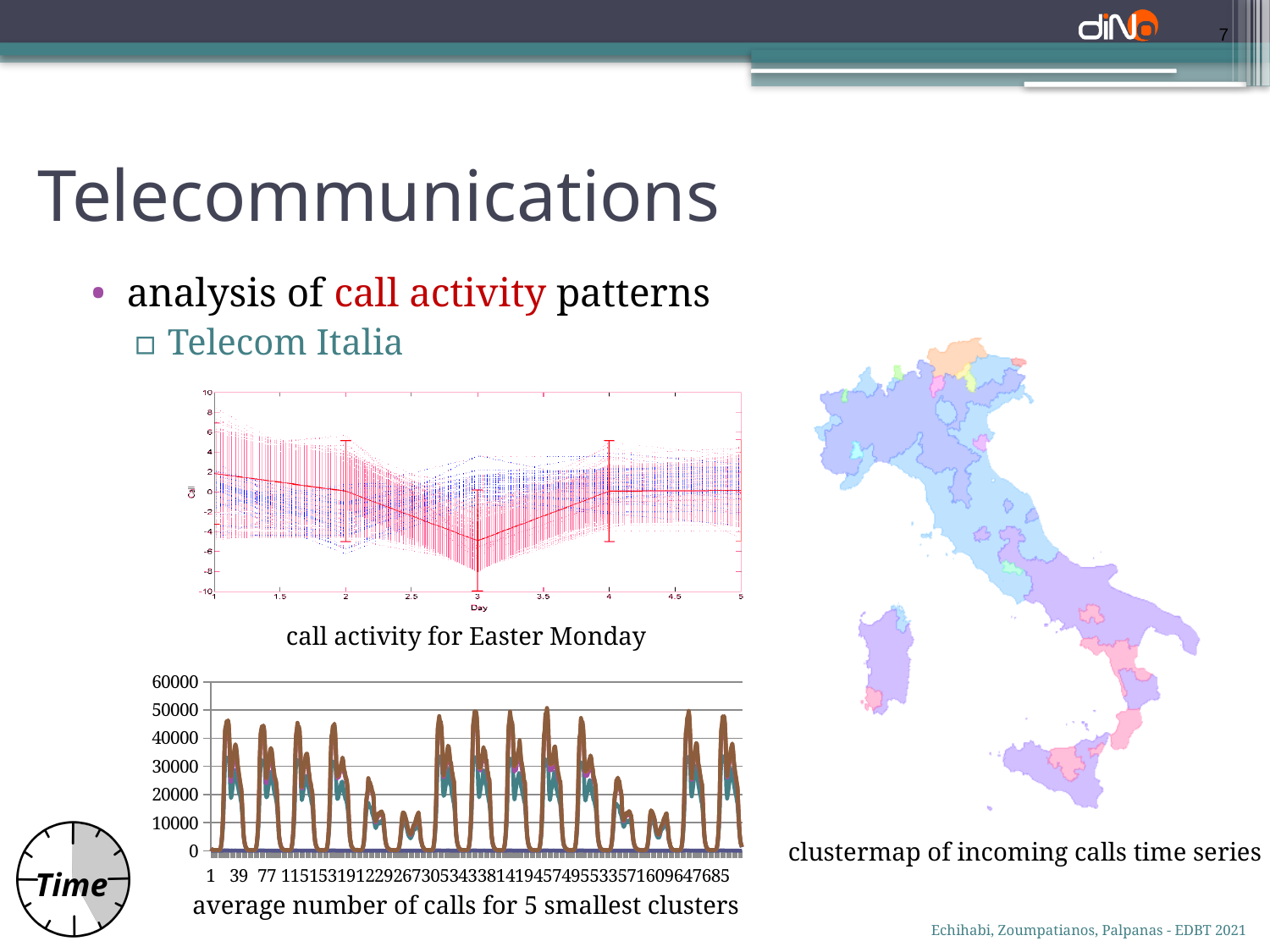
In the chart 'average number of calls for 5 smallest clusters', what is the highest value shown on the y axis? 60000 In the chart 'call activity for Easter Monday', what is the label of the x axis? Day In the chart 'average number of calls for 5 smallest clusters', what is the first label on the x axis? 1 What kind of chart is the bottom-left chart titled 'average number of calls for 5 smallest clusters'? line chart In the chart 'call activity for Easter Monday', is the red line's value at Day 3 greater or less than 0? less In the chart 'average number of calls for 5 smallest clusters', are the highest peaks greater or less than 60000? less In the chart 'call activity for Easter Monday', what is the label of the y axis? Call In the chart 'average number of calls for 5 smallest clusters', are the highest peaks greater or less than 30000? greater In the chart 'call activity for Easter Monday', what are the lowest and highest values shown on the y axis? -10 and 10 In the chart 'call activity for Easter Monday', at which Day does the red line reach its lowest value? 3 In the chart 'average number of calls for 5 smallest clusters', what is the last label on the x axis? 685 In the chart 'call activity for Easter Monday', does the red line rise or fall between Day 1 and Day 3? fall